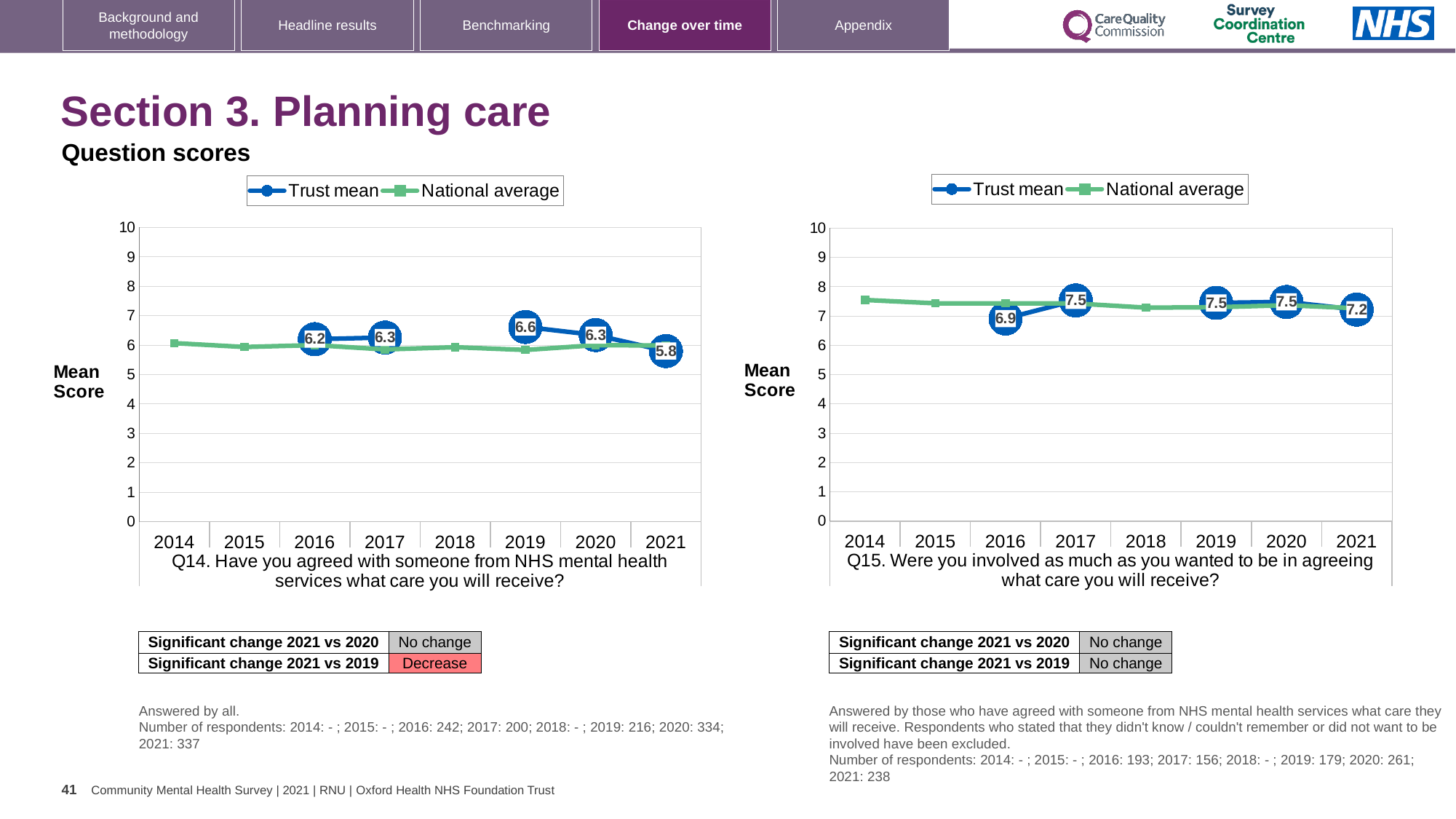
In the Q15 chart on the right, is the Trust mean for 2017 greater or less than the Trust mean for 2016? greater In the Q15 chart on the right, which year has the lowest Trust mean? 2016 In the Q14 chart on the left, what is the Trust mean for 2019? 6.6 In the Q14 chart on the left, what is the Trust mean for 2021? 5.8 In the Q15 chart on the right, what is the Trust mean for 2016? 6.9 In the Q15 chart on the right, is the National average for 2014 greater or less than 7? greater In the Q15 chart on the right, what is the Trust mean for 2021? 7.2 In the Q14 chart on the left, which year has the highest Trust mean? 2019 How many series does the legend of the Q14 chart on the left list? 2 What kind of chart is the Q15 chart on the right? Line chart In the Q14 chart on the left, what is the difference between the Trust mean in 2019 and in 2021? 0.8 In the Q14 chart on the left, which year has the lowest labelled Trust mean? 2021